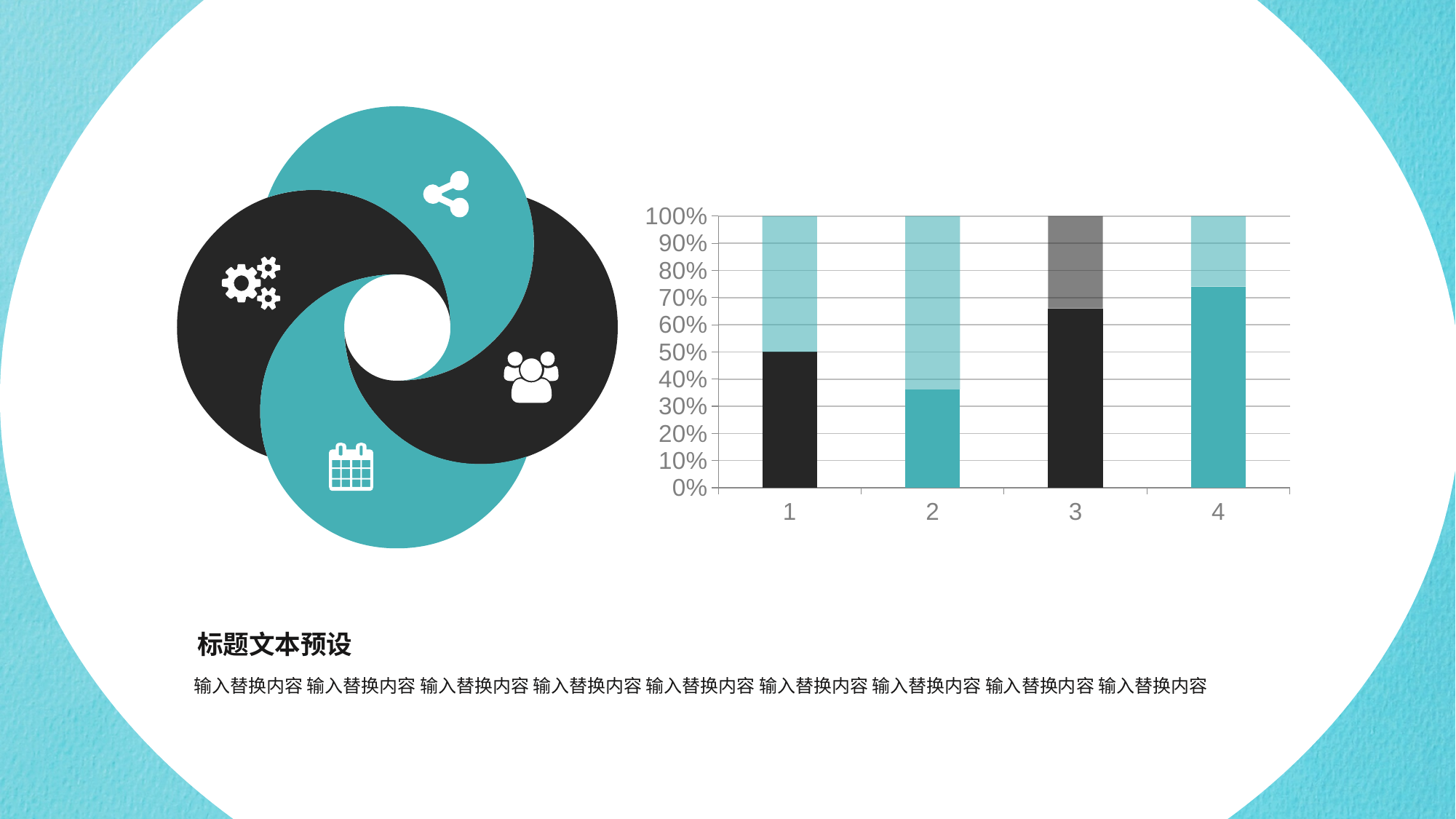
What is the highest value shown on the y axis of the chart? 100% Is the bottom segment of the bar for category 3 greater or less than 60%? greater What colour is the bottom segment of the bar for category 3? black Which category has the largest bottom segment in its bar? 4 What kind of chart is shown on the slide? bar chart Is the bottom segment of the bar for category 2 greater or less than 40%? less What is the total height of each stacked bar in the chart? 100% Which category has the smallest bottom segment in its bar? 2 How many categories are shown on the x axis of the chart? 4 Which has a larger bottom segment, the bar for category 1 or the bar for category 2? 1 Is the bottom segment of the bar for category 4 greater or less than 70%? greater